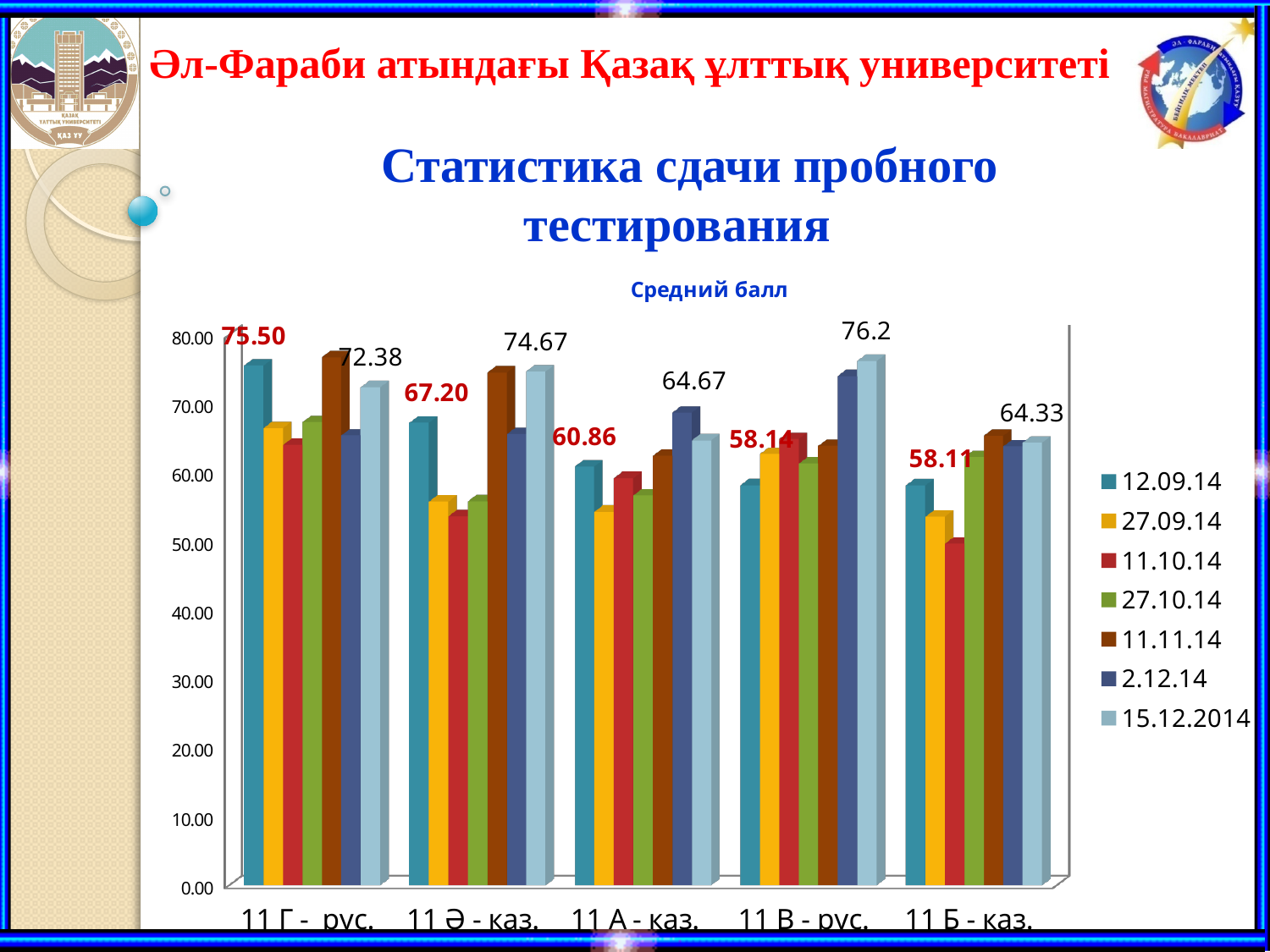
Is the value for 11.11.14 in the 11 Г - рус. category greater or less than 70? greater How many series does the legend list? 7 How many categories are shown on the x axis? 5 What is the difference between the 12.09.14 values for 11 Г - рус. and 11 Б - каз.? 17.39 What is the value for 15.12.2014 in the 11 Ә - каз. category? 74.67 What is the value for 15.12.2014 in the 11 В - рус. category? 76.2 Which category has the highest value for the 12.09.14 series? 11 Г - рус. What is the value for 12.09.14 in the 11 Б - каз. category? 58.11 For 11 Ә - каз., which is larger: the 12.09.14 value or the 15.12.2014 value? 15.12.2014 What type of chart is shown on the slide? bar chart What is the value for 12.09.14 in the 11 Г - рус. category? 75.50 Which category has the highest value for the 15.12.2014 series? 11 В - рус.